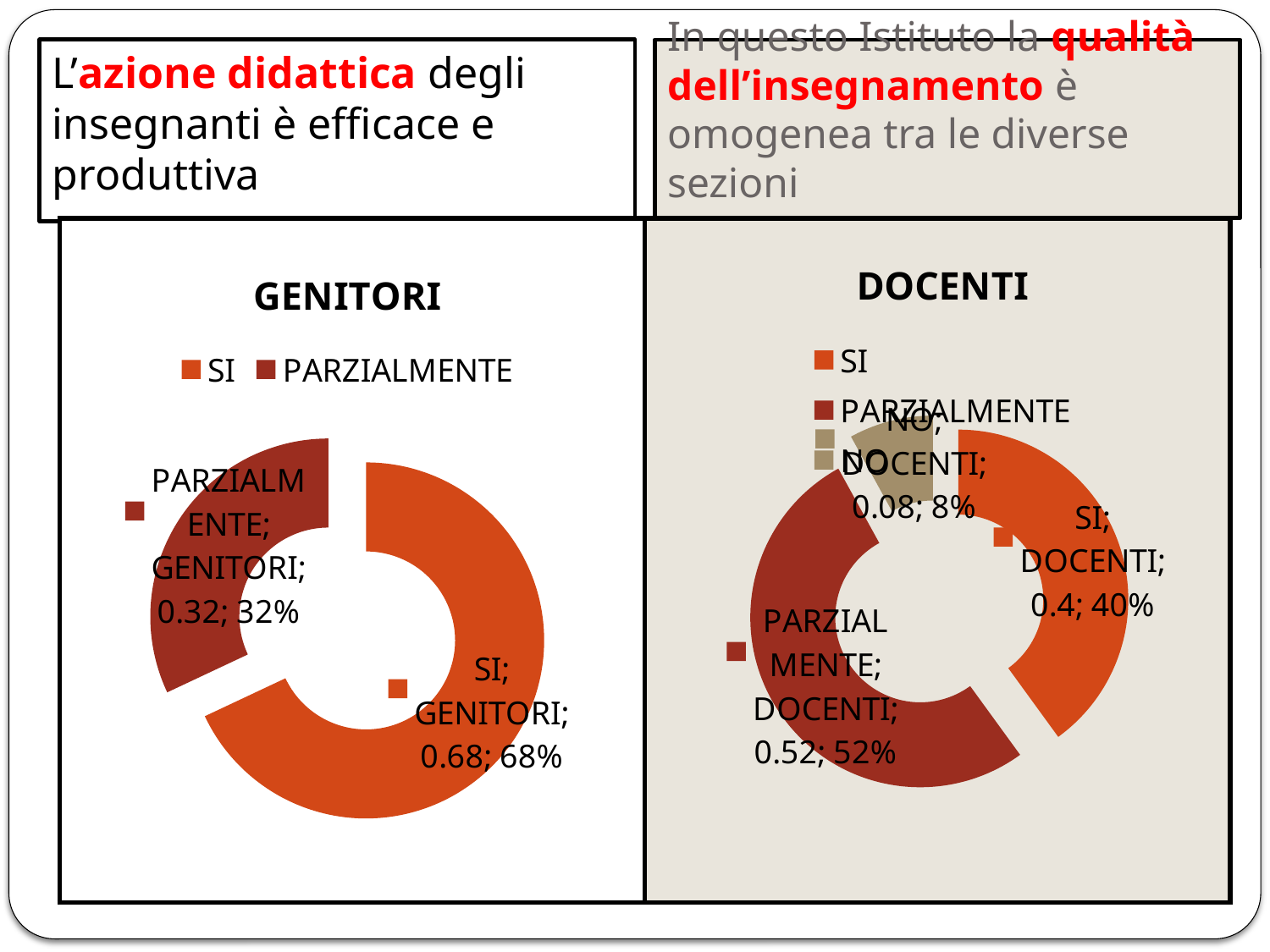
In the DOCENTI chart, what percentage is shown for NO? 8% How many categories does the DOCENTI chart show? 3 In the DOCENTI chart, what percentage is shown for SI? 40% In the DOCENTI chart, what percentage is shown for PARZIALMENTE? 52% In the GENITORI chart, what is the difference in percentage points between SI and PARZIALMENTE? 36 In the DOCENTI chart, which category has the smallest share? NO In the GENITORI chart, what percentage is shown for SI? 68% In the DOCENTI chart, which category has the largest share? PARZIALMENTE What kind of chart is the GENITORI chart? doughnut chart In the GENITORI chart, what percentage is shown for PARZIALMENTE? 32% In the GENITORI chart, which category has the larger share, SI or PARZIALMENTE? SI In the DOCENTI chart, what is the difference in percentage points between PARZIALMENTE and SI? 12